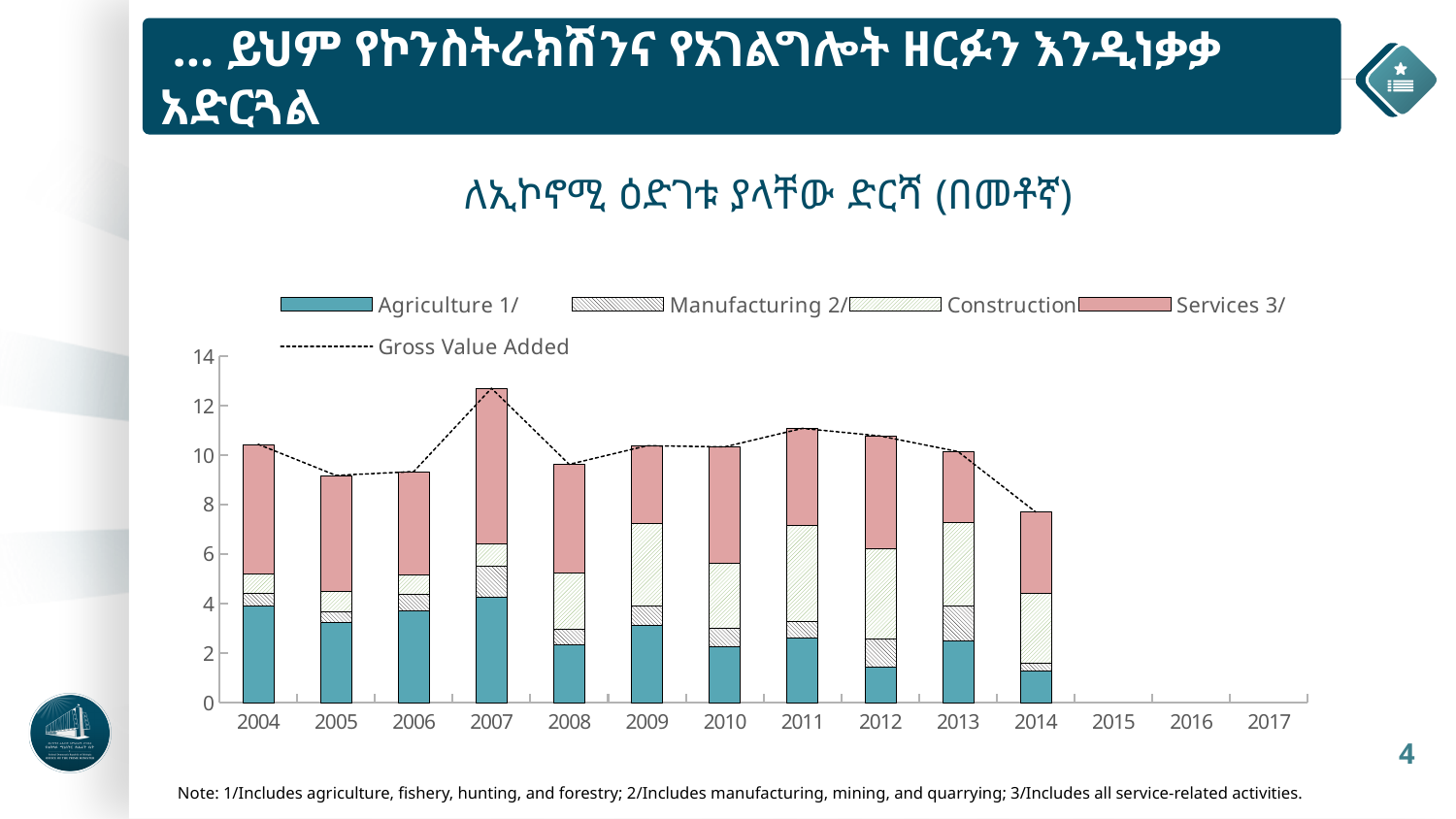
Does the Gross Value Added rise or fall from 2011 to 2014? fall Which year has the lowest Gross Value Added? 2014 Which year has the highest Gross Value Added? 2007 Is the Agriculture 1/ value for 2014 greater or less than 2? less Which series is plotted as a dashed line rather than as bars? Gross Value Added Which year has the larger Gross Value Added, 2007 or 2014? 2007 How many years have bars plotted on the chart? 11 Is the Gross Value Added for 2014 greater or less than 8? less Is the Gross Value Added for 2005 greater or less than 10? less What kind of chart is shown on the slide? stacked bar chart with a line How many series does the legend list? 5